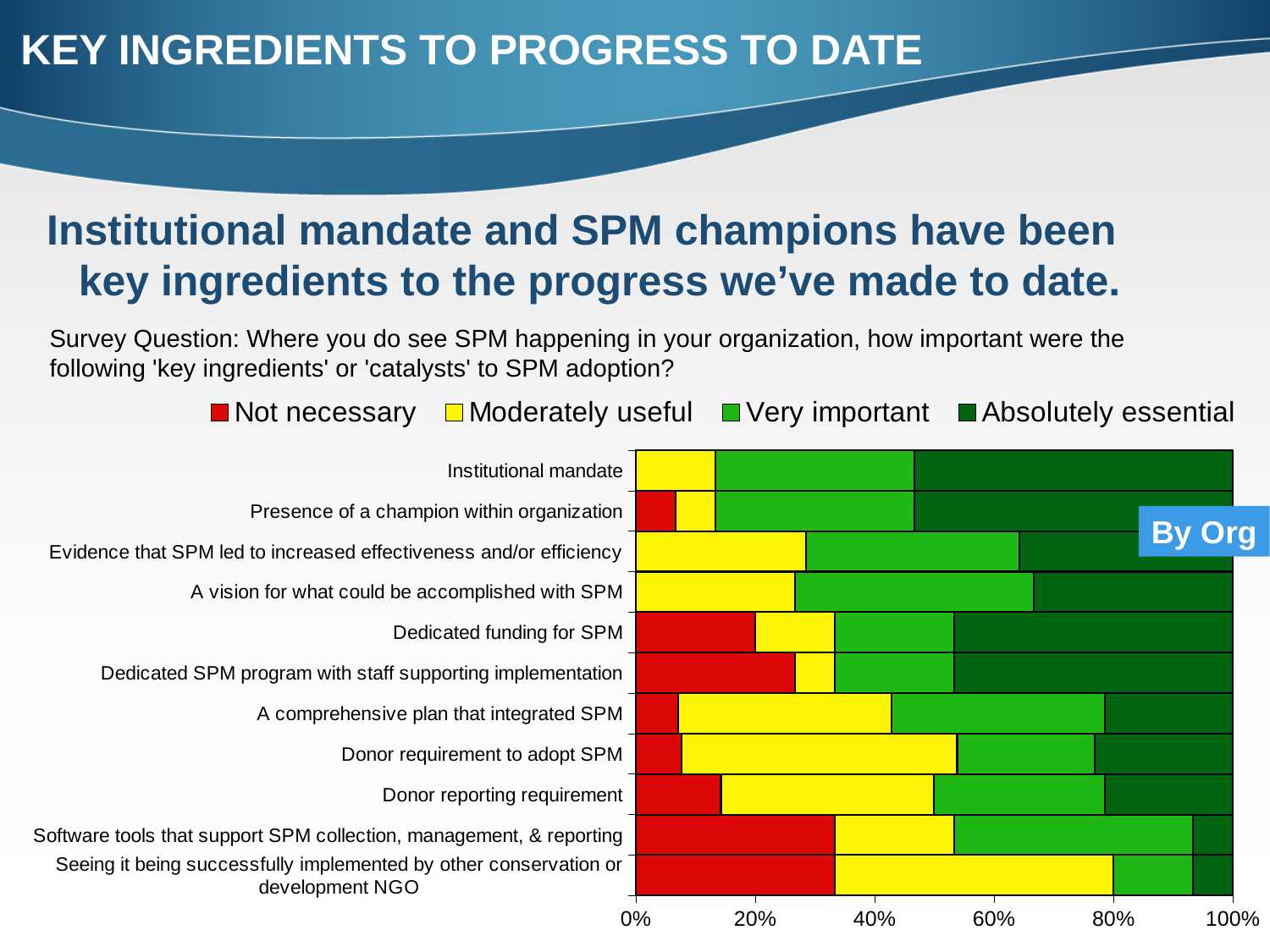
Is the 'Not necessary' share for 'Software tools that support SPM collection, management, & reporting' greater or less than 20%? greater What label appears in the blue box at the right of the chart? By Org Which has the larger 'Absolutely essential' share: 'Institutional mandate' or 'Seeing it being successfully implemented by other conservation or development NGO'? Institutional mandate How many categories have no 'Not necessary' (red) segment at all? 3 Which has the larger 'Moderately useful' share: 'Donor requirement to adopt SPM' or 'Institutional mandate'? Donor requirement to adopt SPM What kind of chart is shown on the slide? Stacked bar chart Which response category is shown in red in the legend? Not necessary How many key ingredients (categories) are plotted on the chart? 11 Which has the larger 'Not necessary' share: 'Dedicated funding for SPM' or 'Presence of a champion within organization'? Dedicated funding for SPM Is the combined share of 'Not necessary' and 'Moderately useful' for 'Institutional mandate' greater or less than 20%? less How many series does the chart's legend list? 4 Is the 'Not necessary' share for 'Presence of a champion within organization' greater or less than 20%? less